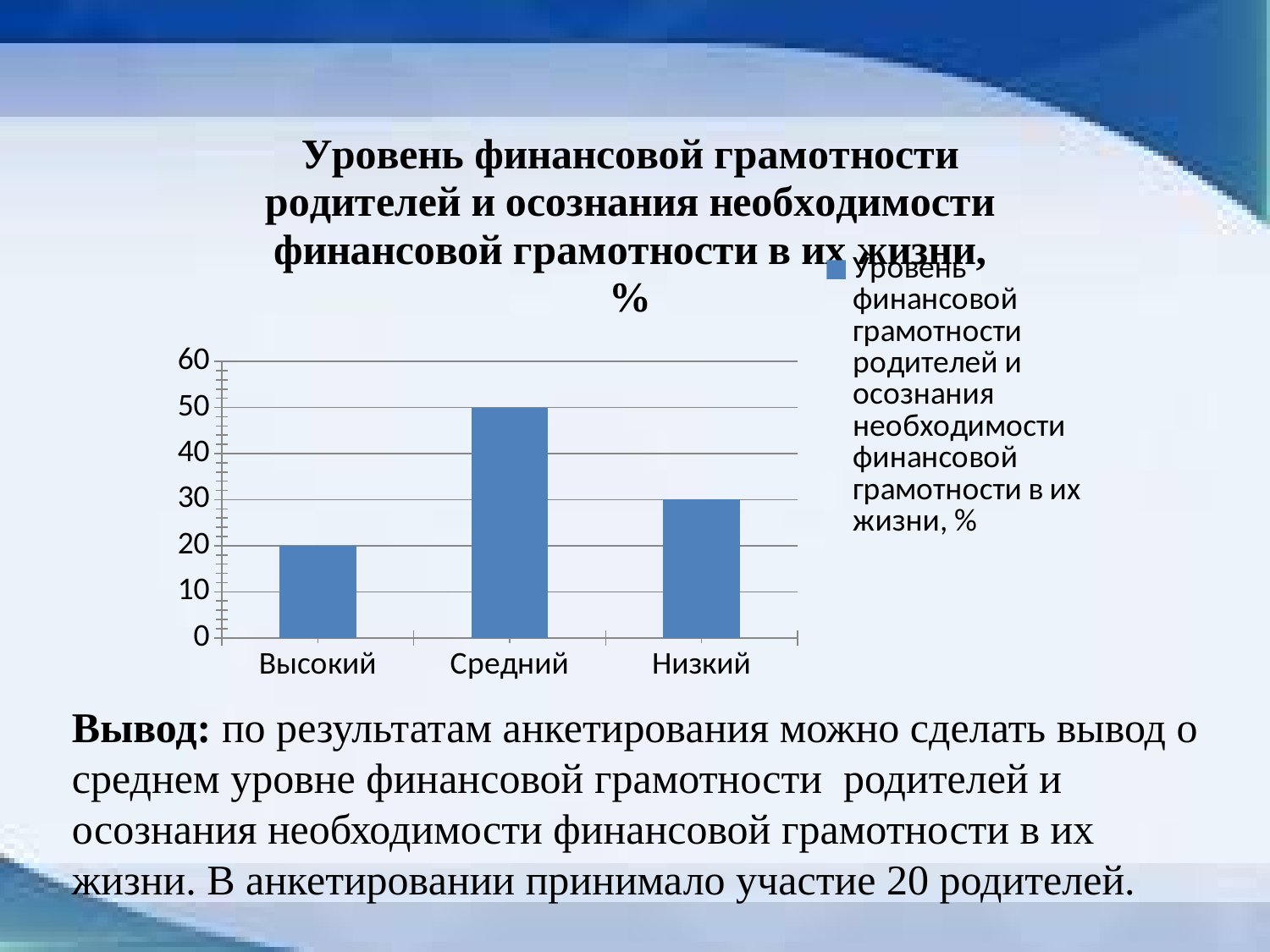
How many categories are shown on the x axis of the chart? 3 Which is larger, the value for Низкий or the value for Высокий? Низкий Which category has the highest value? Средний What is the value for the category Высокий? 20 What is the value for the category Низкий? 30 What kind of chart is shown on the slide? bar chart How many series does the legend list? 1 What is the difference between the values for Средний and Низкий? 20 What is the label of the first category on the x axis? Высокий Which category has the lowest value? Высокий What is the value for the category Средний? 50 Is the value for Средний greater or less than 40? greater